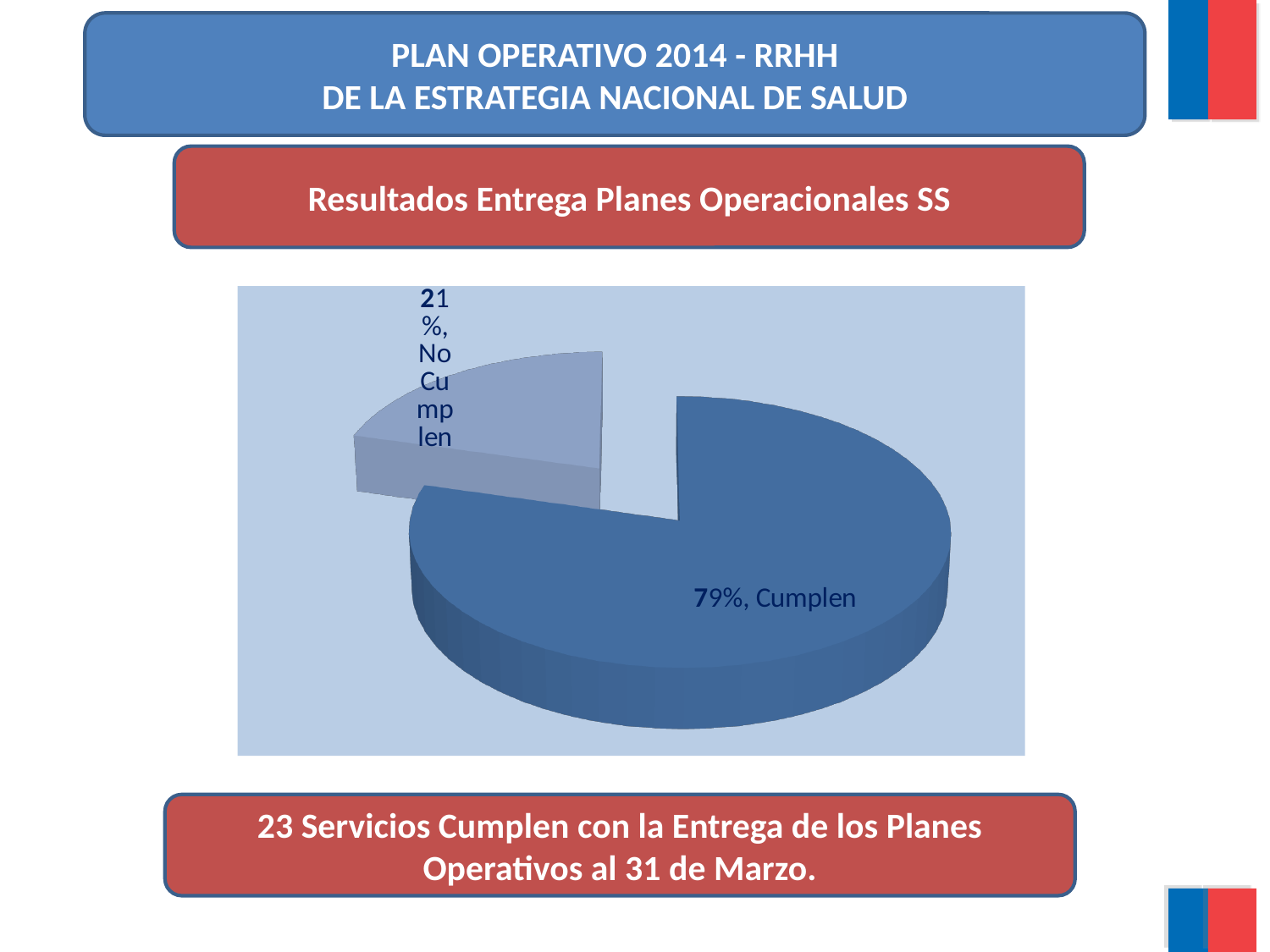
Which slice of the pie chart is the largest? Cumplen Which slice of the pie chart is pulled out (exploded) from the rest of the pie? No Cumplen Which is larger in the pie chart, Cumplen or No Cumplen? Cumplen What share of the pie does the Cumplen slice represent? 79% What percentage of the pie is labelled "Cumplen"? 79% How many slices does the pie chart have? 2 What is the heading shown in the red box directly above the chart? Resultados Entrega Planes Operacionales SS Is the share for No Cumplen greater or less than 50%? less What is the difference in percentage points between the Cumplen and No Cumplen slices? 58 What percentage of the pie is labelled "No Cumplen"? 21% Which slice of the pie chart is the smallest? No Cumplen What kind of chart is shown on the slide? Pie chart